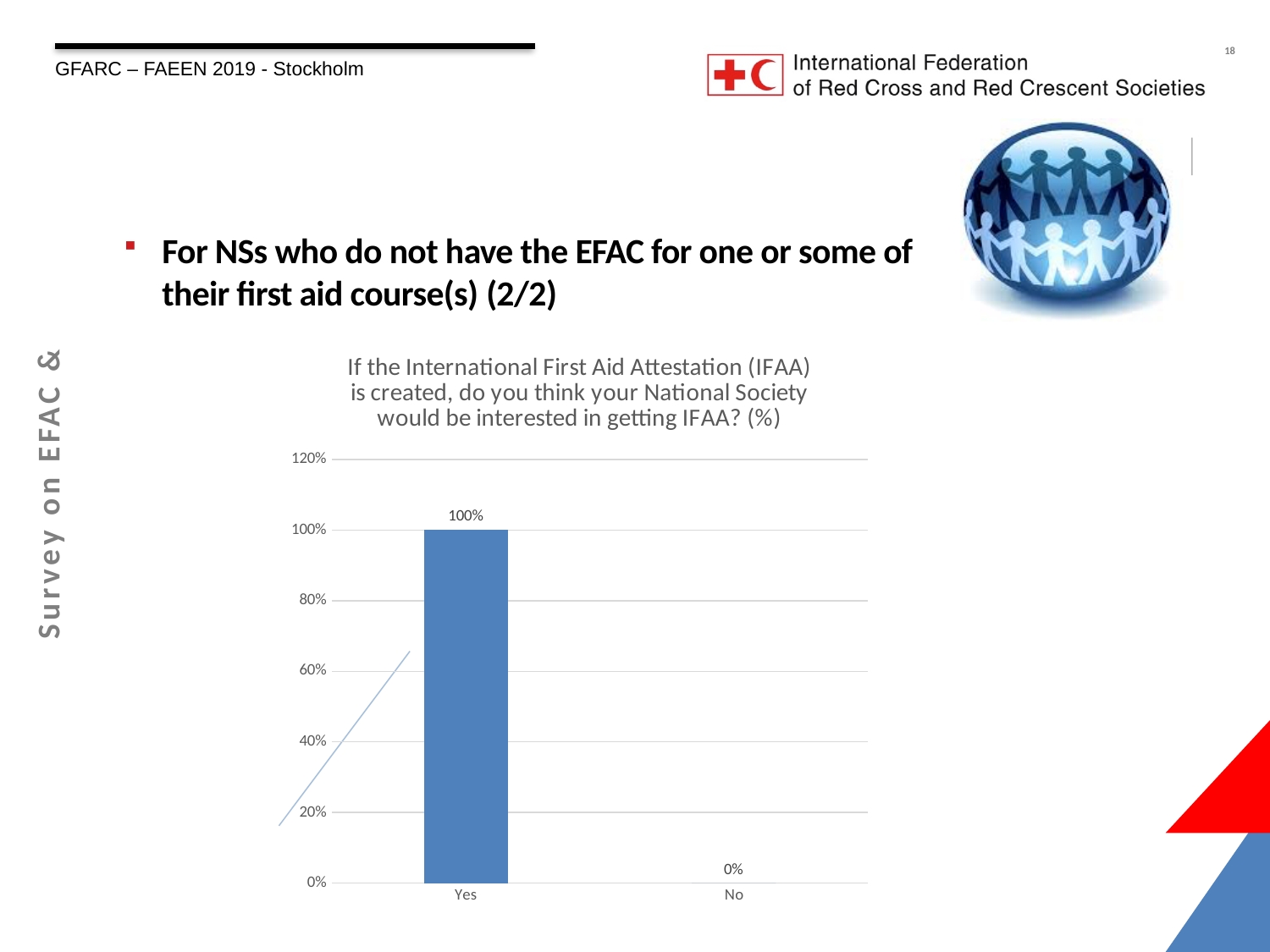
What is the value for No? 0% What is the highest value shown on the y axis? 120% What colour is the bar for Yes? blue Which category has the lowest value? No Do the values rise or fall from Yes to No along the x axis? fall Which is larger, the value for Yes or the value for No? Yes What kind of chart is shown on the slide? bar chart Which category has the highest value? Yes How many categories are shown on the x axis? 2 What is the difference between the values for Yes and No? 100% What is the value for Yes? 100% Is the value for Yes greater or less than 80%? greater